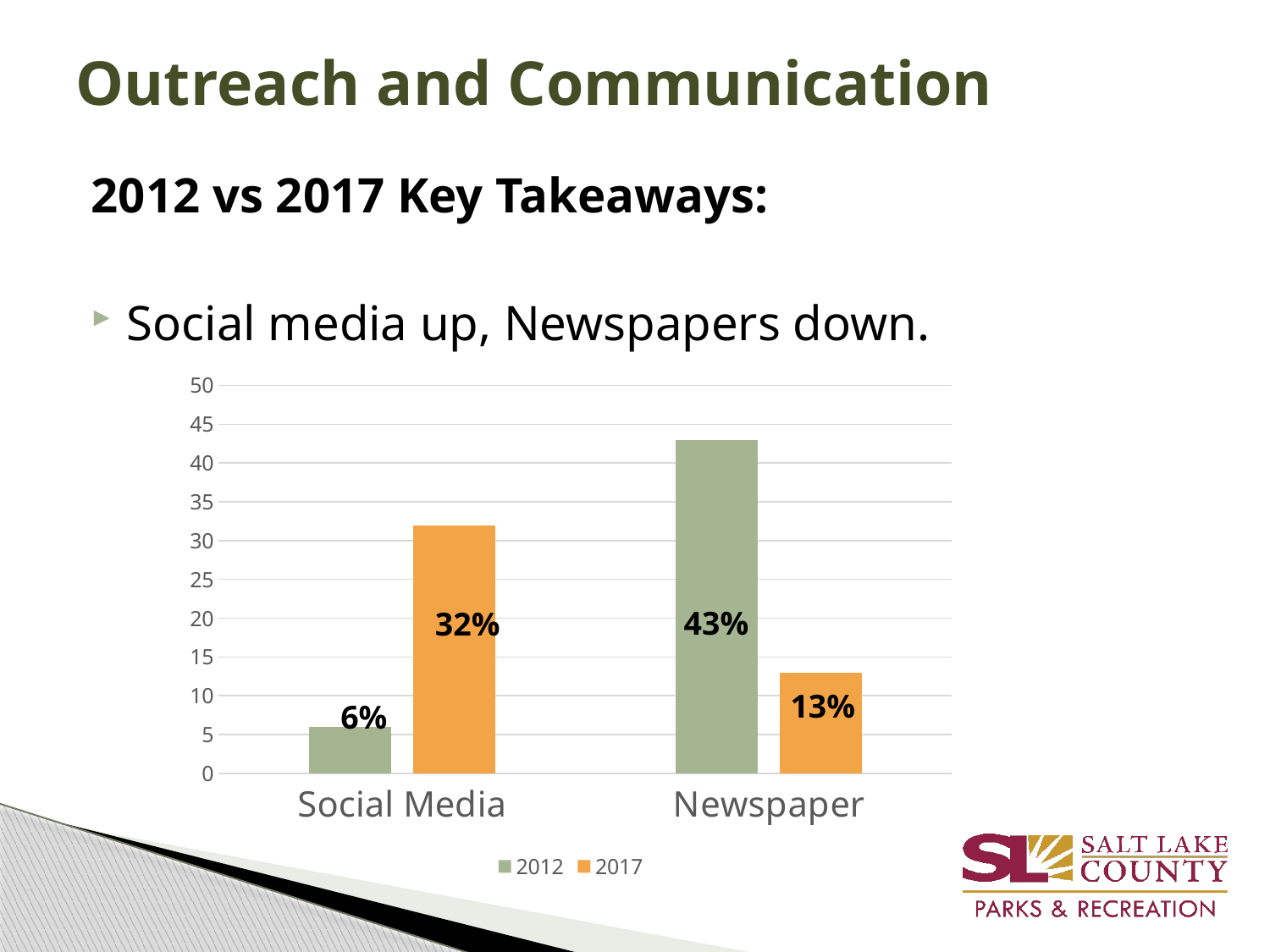
What is the difference between the Newspaper values for 2012 and 2017? 30% What is the value for Newspaper in 2012? 43% What is the difference between the Social Media values for 2017 and 2012? 26% How many series does the legend list? 2 Which category has the lowest value in 2017? Newspaper What kind of chart is shown on the slide? Bar chart How many categories are shown on the x axis? 2 What is the value for Social Media in 2012? 6% What is the value for Newspaper in 2017? 13% Which category has the highest value in 2012? Newspaper Which is larger: Social Media in 2017 or Newspaper in 2017? Social Media in 2017 What is the value for Social Media in 2017? 32%